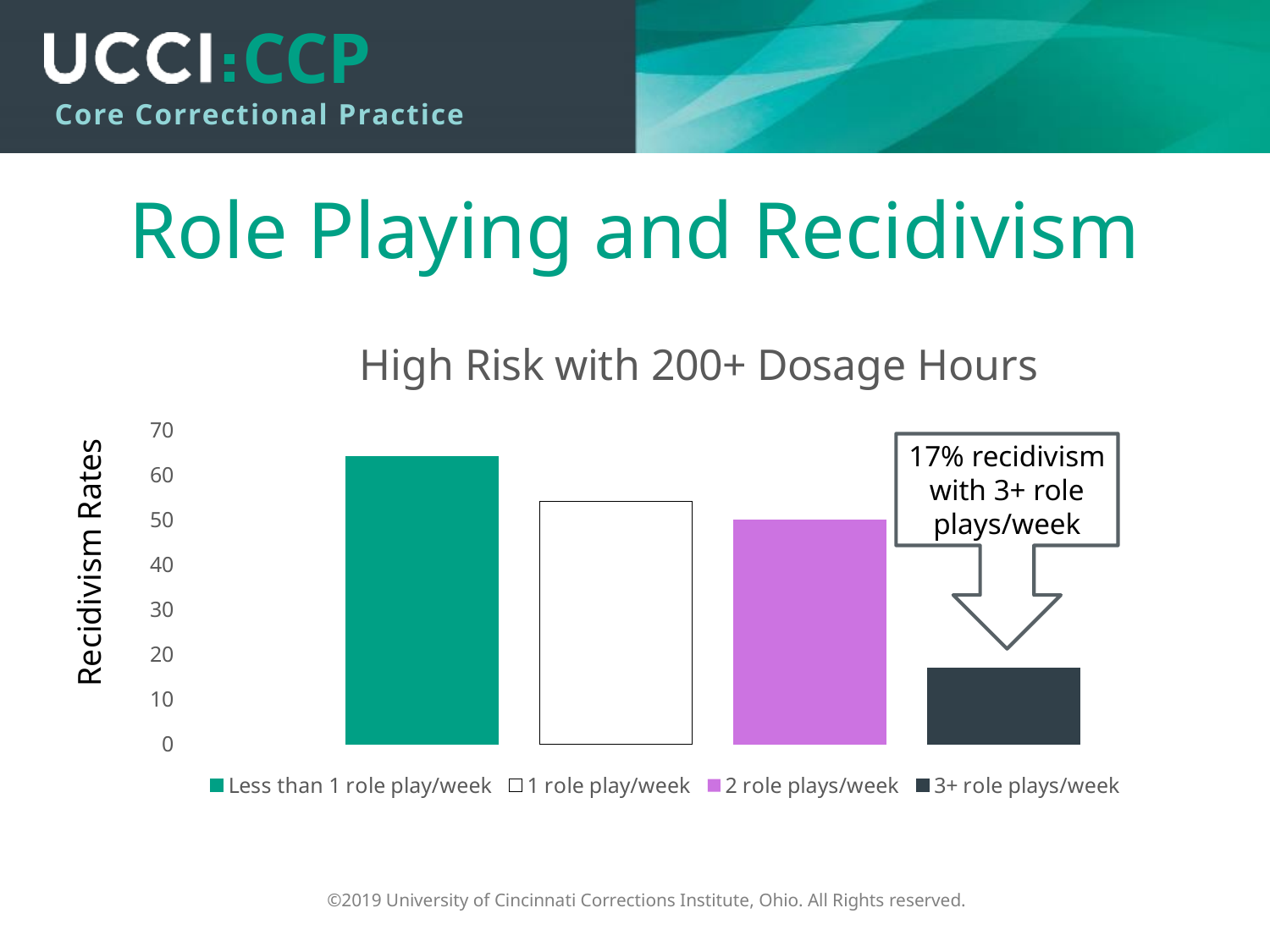
Is the recidivism rate for 2 role plays/week greater or less than 40? greater Is the recidivism rate for Less than 1 role play/week greater or less than 60? greater What is the title of the chart? High Risk with 200+ Dosage Hours What is the recidivism rate for 3+ role plays/week? 17% Which has a higher recidivism rate: Less than 1 role play/week or 2 role plays/week? Less than 1 role play/week Which series has the highest recidivism rate? Less than 1 role play/week What type of chart is shown on the slide? bar chart How many series does the chart legend list? 4 Do the recidivism rates rise or fall as the number of role plays per week increases from left to right? fall Which series has the lowest recidivism rate? 3+ role plays/week Is the recidivism rate for 1 role play/week greater or less than 60? less What is the label on the vertical axis of the chart? Recidivism Rates